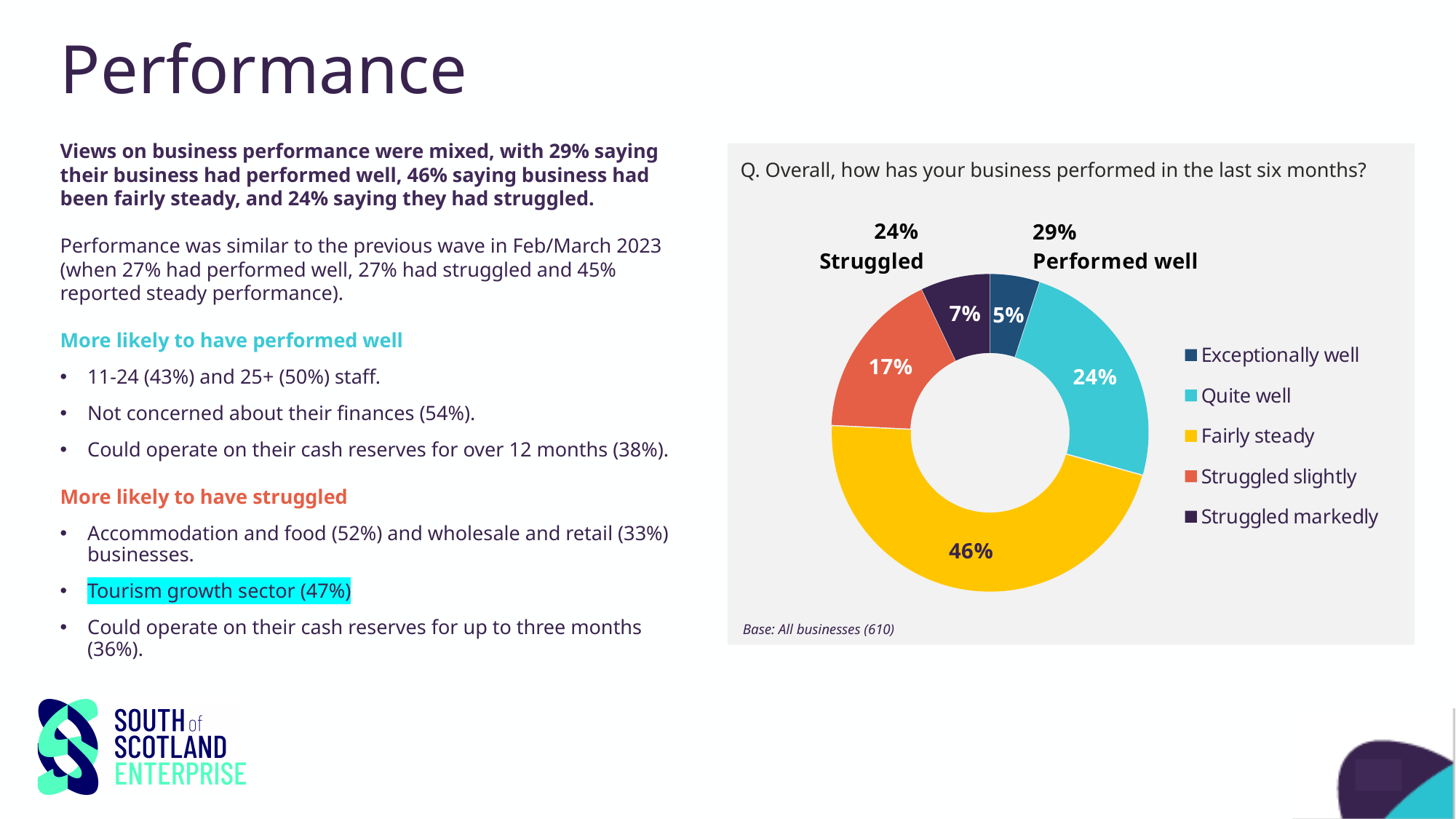
What percentage of businesses said they had 'Struggled markedly'? 7% How many response categories does the legend list? 5 Which response category has the largest share of the chart? Fairly steady Which is larger: the share for 'Quite well' or the share for 'Struggled markedly'? Quite well What kind of chart is shown on the slide? Doughnut (pie) chart Which response category has the smallest share of the chart? Exceptionally well What is the difference in percentage points between 'Quite well' and 'Struggled slightly'? 7 What percentage of businesses said they had performed 'Fairly steady'? 46% What percentage of businesses said they had performed 'Exceptionally well'? 5% What is the base (number of businesses) stated beneath the chart? All businesses (610) What percentage of businesses said they had 'Struggled slightly'? 17% What combined percentage is labelled as 'Performed well' on the chart? 29%